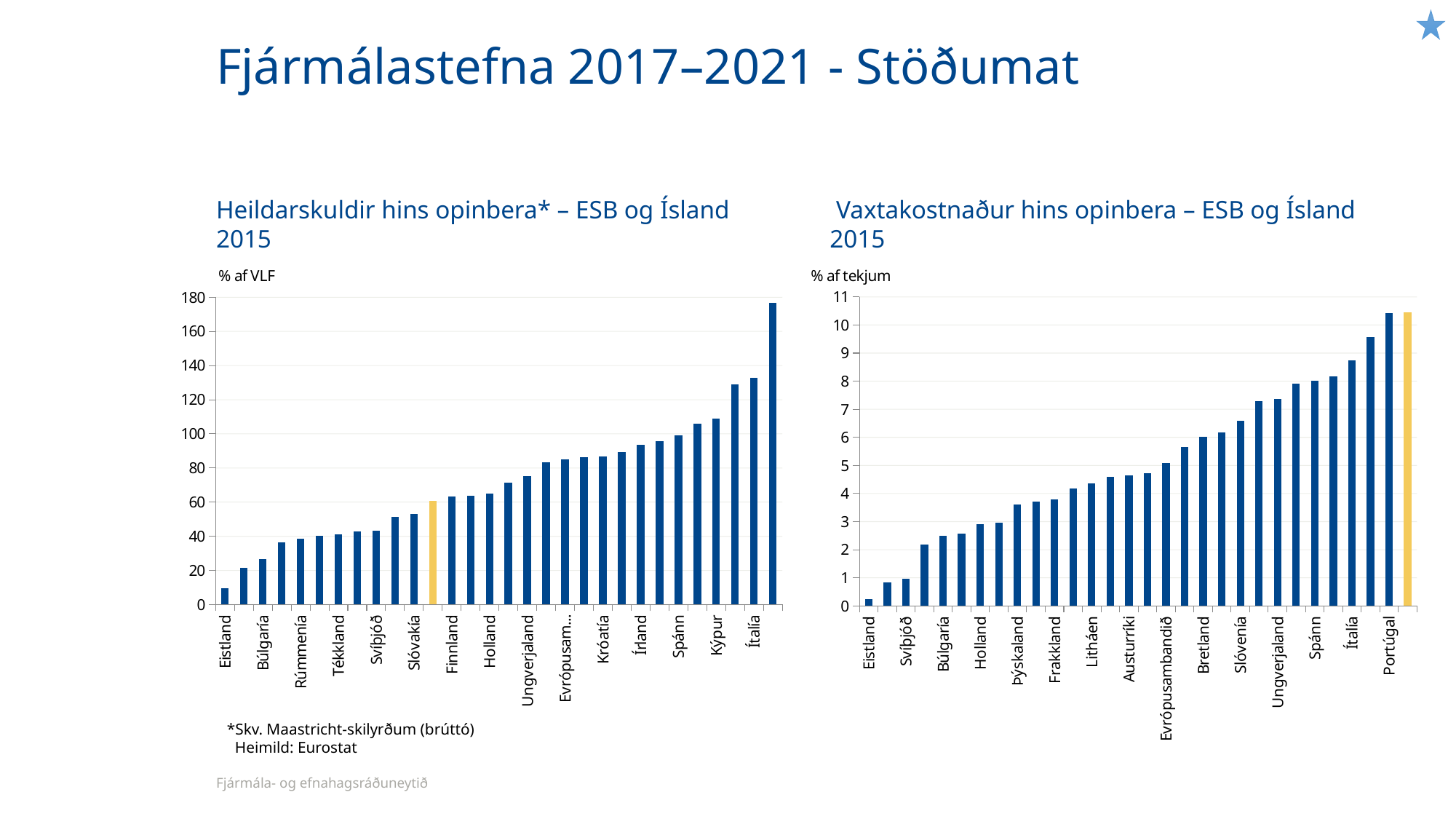
In the right chart 'Vaxtakostnaður hins opinbera', is the value for Ítalía greater or less than 8? greater In the left chart 'Heildarskuldir hins opinbera', is the value for Ítalía greater or less than 120? greater In the left chart 'Heildarskuldir hins opinbera', which is larger, the value for Ítalía or the value for Kýpur? Ítalía What kind of chart is the left chart, 'Heildarskuldir hins opinbera* – ESB og Ísland 2015'? Bar chart In the left chart 'Heildarskuldir hins opinbera', which labelled country has the lowest value? Eistland In the left chart 'Heildarskuldir hins opinbera', is the value for Ungverjaland greater or less than 80? less In the right chart 'Vaxtakostnaður hins opinbera', which is larger, the value for Portúgal or the value for Spánn? Portúgal What unit is shown on the y axis of the left chart 'Heildarskuldir hins opinbera'? % af VLF In the left chart 'Heildarskuldir hins opinbera', do the values rise or fall from left to right along the x axis? Rise In the right chart 'Vaxtakostnaður hins opinbera', which labelled country has the lowest value? Eistland